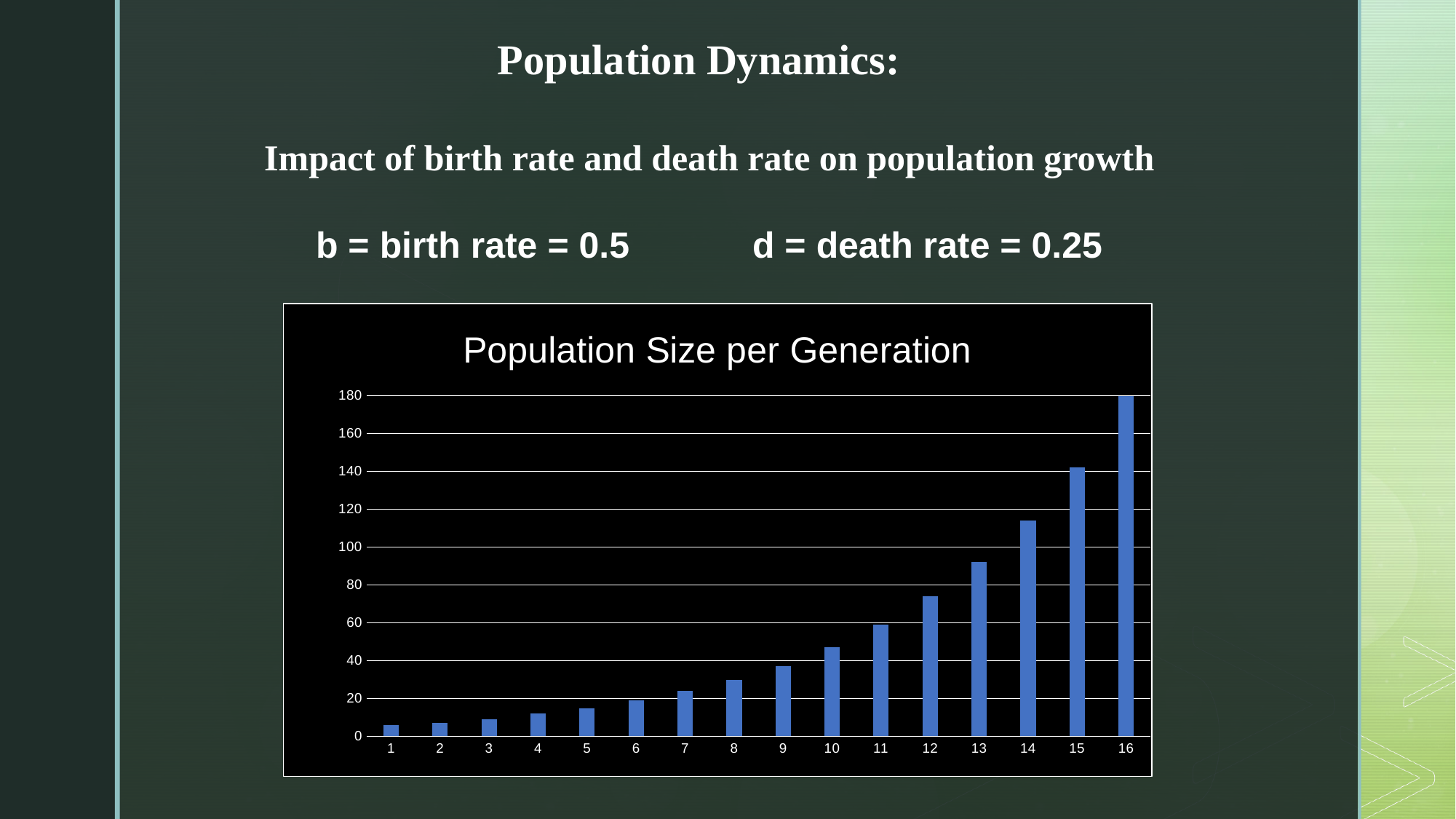
Is the population size for generation 15 greater or less than 120? greater Is the population size for generation 5 greater or less than 20? less What kind of chart is shown on the slide? bar chart Do the population sizes rise or fall as the generation number increases? rise Is the population size for generation 9 greater or less than 40? less Which generation has a larger population size, generation 12 or generation 14? 14 How many generations are plotted on the x axis of the chart? 16 Which generation has the smallest population size in the chart? 1 Which generation has the largest population size in the chart? 16 What is the title of the chart? Population Size per Generation